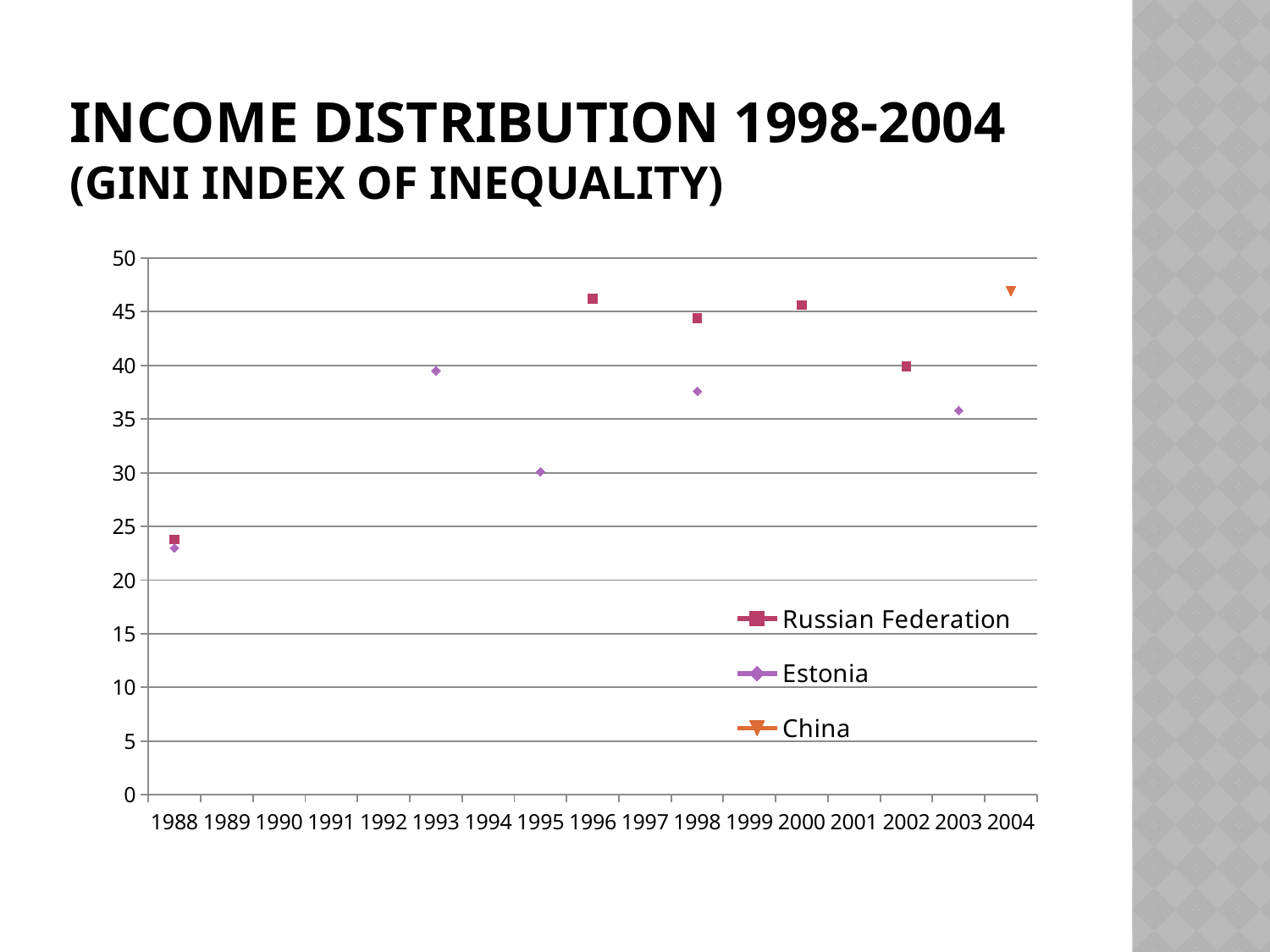
Is the value for the Russian Federation in 2002 greater or less than 45? less How many series does the legend list? 3 Is the value for the Russian Federation in 1996 greater or less than 45? greater How many years are labelled on the x axis? 17 Is the value for Estonia in 2003 greater or less than 40? less In which year is the Estonia value lowest? 1988 What kind of chart is shown on the slide? line chart Which series are listed in the legend? Russian Federation, Estonia, China In which year is the Russian Federation value lowest? 1988 In 1998, which is larger: the value for the Russian Federation or the value for Estonia? Russian Federation